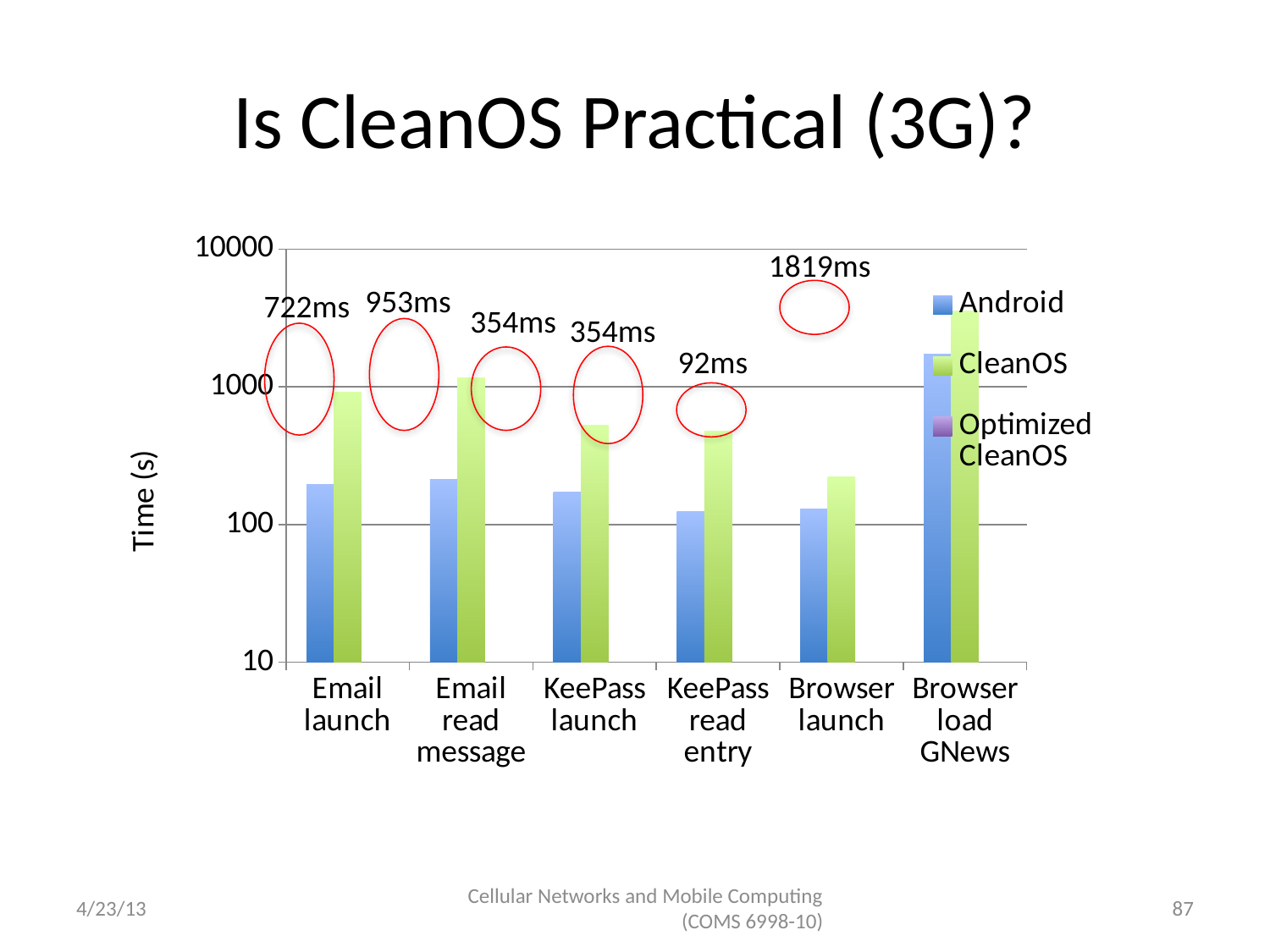
How many series does the chart's legend list? 3 Is the CleanOS value for Email read message greater or less than 1000? greater Is the CleanOS value for Browser launch greater or less than 100? greater For Email launch, which is larger: the Android value or the CleanOS value? CleanOS Is the CleanOS value for KeePass launch greater or less than 1000? less Which series are listed in the legend? Android, CleanOS, Optimized CleanOS What is the label of the y axis? Time (s) What kind of chart is shown on the slide? bar chart For which category is the CleanOS bar the tallest? Browser load GNews How many categories are shown along the x axis of the chart? 6